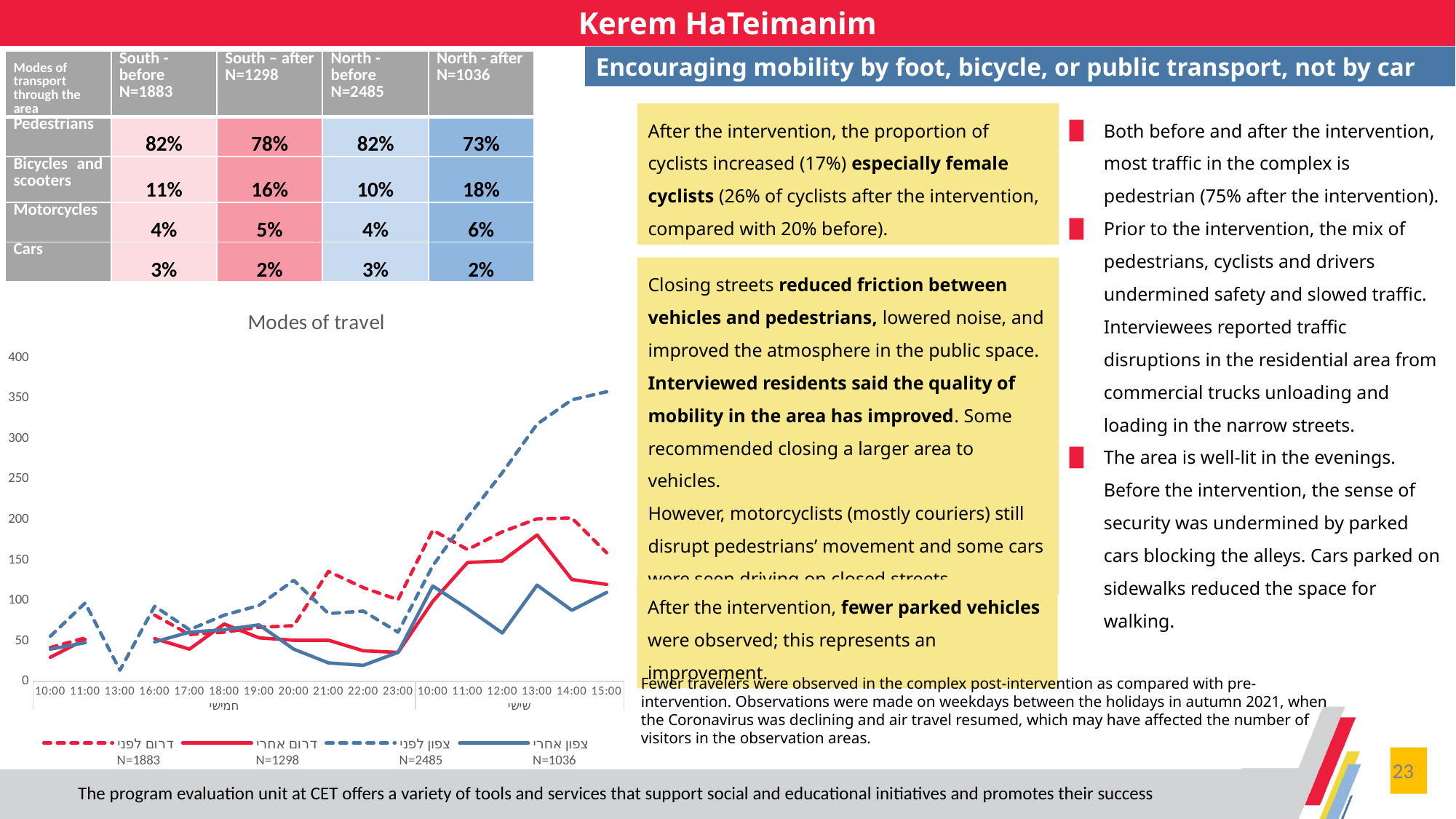
In the "Modes of travel" chart, is the value of the solid red series (N=1298) at 13:00 on the second day greater or less than 150? greater In the "Modes of travel" chart, is the value of the dashed blue series (N=2485) at 15:00 on the second day greater or less than 300? greater In the "Modes of travel" chart, which series reaches the highest value anywhere on the chart? the dashed blue series (N=2485) How many time points are shown along the x axis of the "Modes of travel" chart? 17 How many series does the legend of the "Modes of travel" chart list? 4 In the "Modes of travel" chart, at 15:00 on the second day, which is larger: the dashed blue series (N=2485) or the solid blue series (N=1036)? the dashed blue series (N=2485) What is the title of the line chart on the slide? Modes of travel What kind of chart is the "Modes of travel" chart? line chart What is the highest value shown on the y axis of the "Modes of travel" chart? 400 In the "Modes of travel" chart, is the value of the dashed red series (N=1883) at 10:00 on the second day greater or less than 150? greater In the "Modes of travel" chart, does the dashed blue series (N=2485) rise or fall from 10:00 to 15:00 on the second day? rise